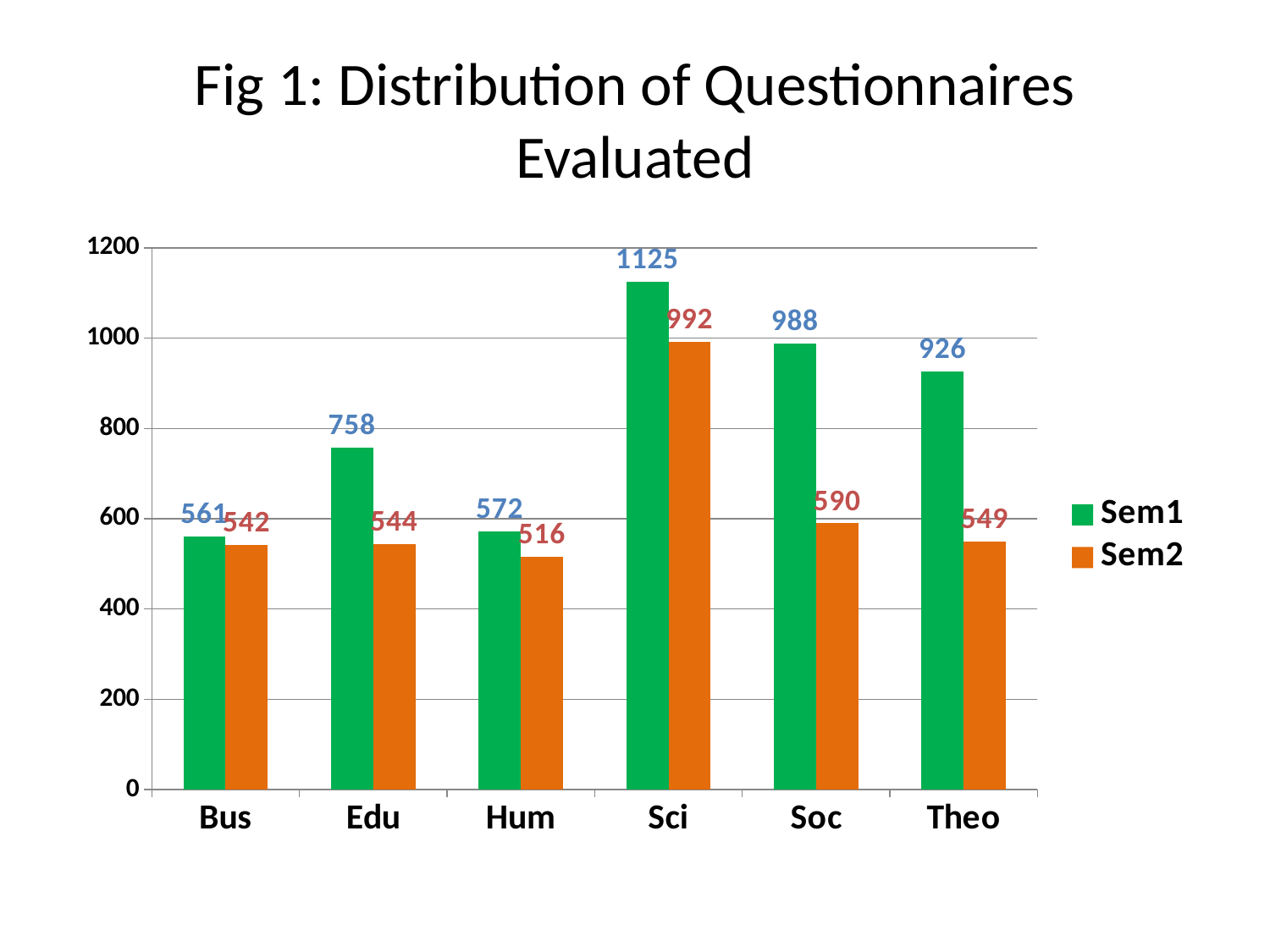
What is the Sem1 value for Edu? 758 What is the difference between the Sem1 and Sem2 values for Theo? 377 How many categories are shown on the x axis? 6 Which category has the highest Sem2 value? Sci What kind of chart is shown on the slide? bar chart How many series does the legend list? 2 Which category has the lowest Sem2 value? Hum Which is larger, the Sem1 value for Soc or the Sem1 value for Theo? Soc What is the Sem2 value for Soc? 590 Is the Sem1 value for Sci greater or less than 1000? greater What is the Sem1 value for Sci? 1125 What is the title of the chart? Fig 1: Distribution of Questionnaires Evaluated